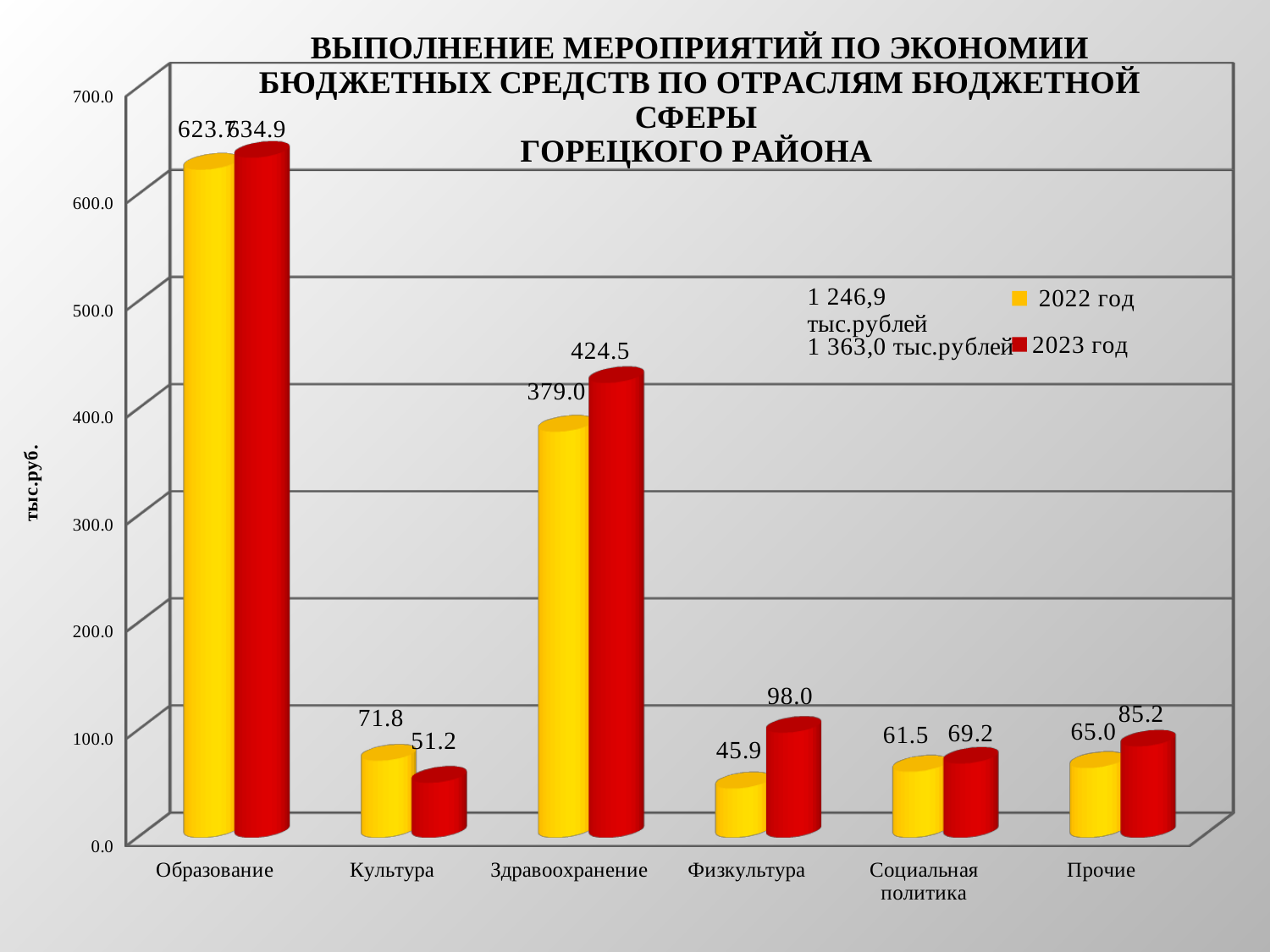
Which category has the highest value for 2023 год? Образование What is the difference between the 2023 год and 2022 год values for Физкультура? 52.1 For Культура, which series has the larger value, 2022 год or 2023 год? 2022 год What is the label on the vertical axis? тыс.руб. How many categories are shown on the x axis? 6 What is the value for Здравоохранение in 2023 год? 424.5 What is the value for Культура in 2022 год? 71.8 How many series does the legend list? 2 Which category has the lowest value for 2022 год? Физкультура Is the value for Образование in 2023 год greater or less than 600? greater What is the value for Физкультура in 2022 год? 45.9 What kind of chart is shown on the slide? bar chart